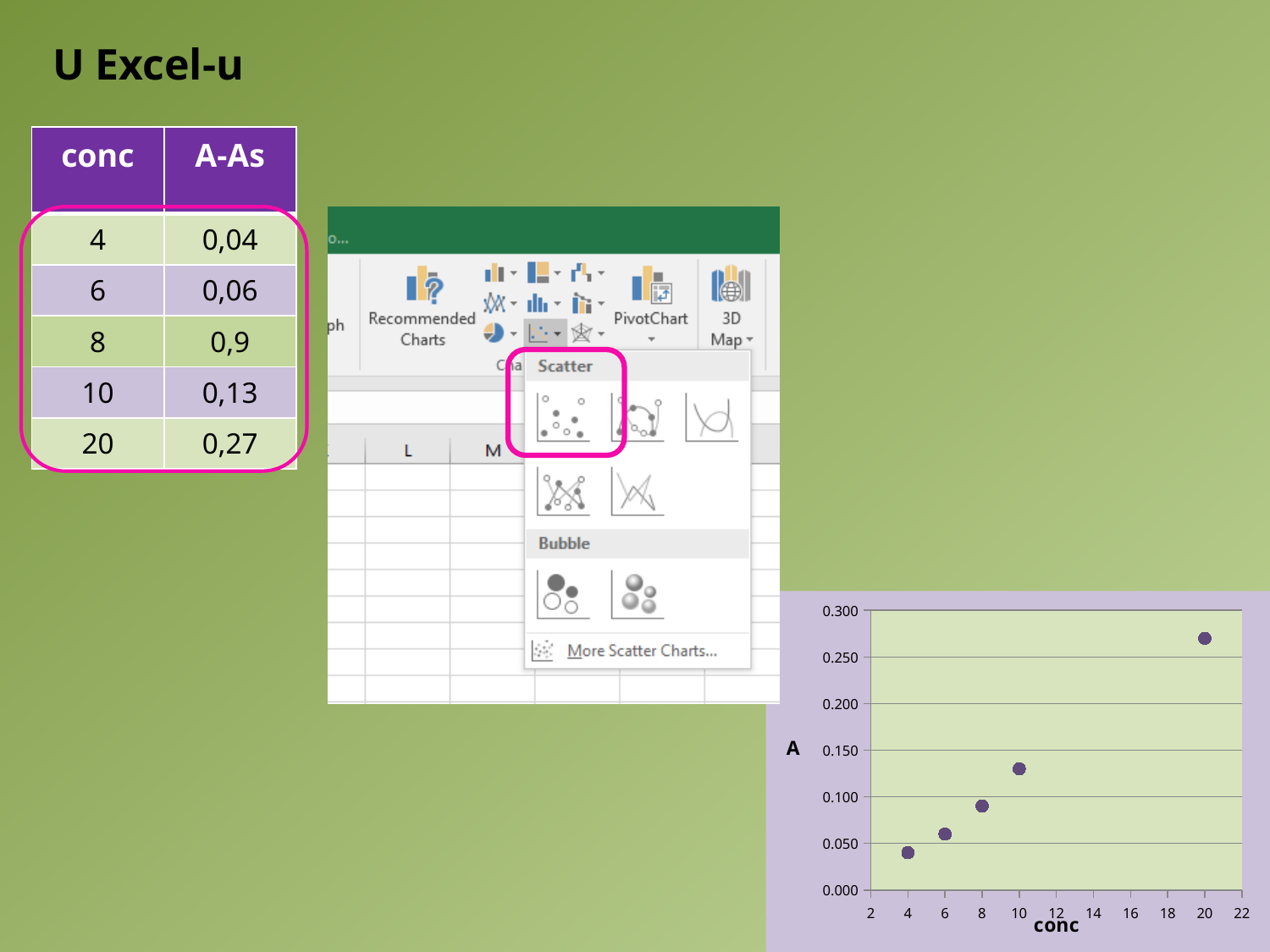
In the scatter chart, do the values of A rise or fall as conc increases? rise In the scatter chart, which conc value has the lowest A? 4 In the scatter chart, is the value of A at conc 20 greater or less than 0.250? greater In the scatter chart, which conc value has the highest A? 20 In the scatter chart, is the value of A at conc 10 greater or less than 0.150? less What is the label on the y axis of the scatter chart? A In the scatter chart, which has the larger A value: conc 10 or conc 8? conc 10 What is the label on the x axis of the scatter chart? conc In the scatter chart, is the value of A at conc 4 greater or less than 0.050? less What kind of chart is shown at the bottom right of the slide? scatter chart How many data points are plotted in the scatter chart? 5